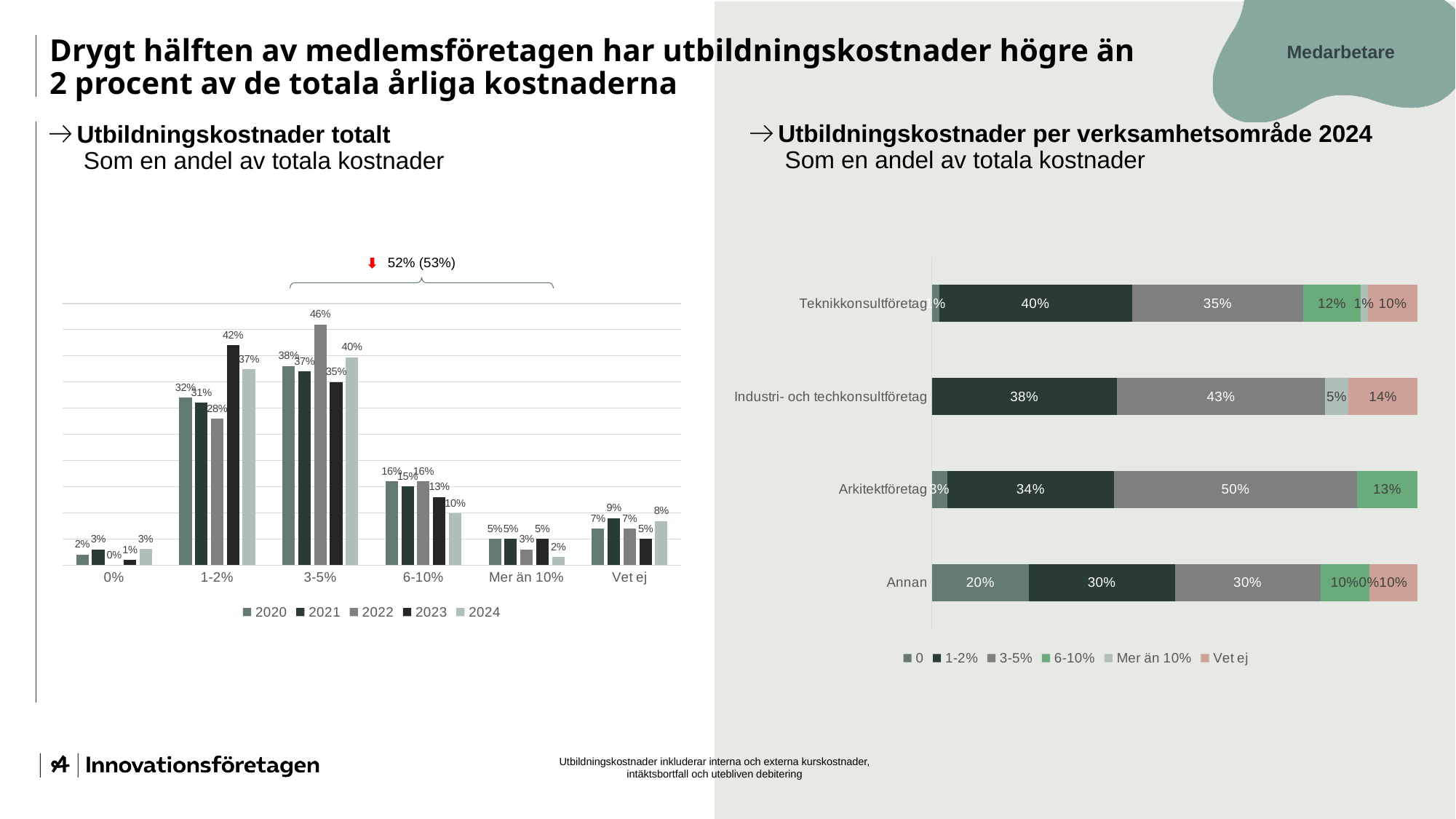
How many categories are shown on the x axis of the left chart 'Utbildningskostnader totalt'? 6 In the left chart 'Utbildningskostnader totalt', what is the value for 2023 in the '1-2%' category? 42% In the right chart 'Utbildningskostnader per verksamhetsområde 2024', what is the 'Vet ej' share for Industri- och techkonsultföretag? 14% In the left chart 'Utbildningskostnader totalt', what is the value for 2022 in the '3-5%' category? 46% In the left chart 'Utbildningskostnader totalt', which year has the highest value in the '6-10%' category? 2020 and 2022 (16%) In the left chart 'Utbildningskostnader totalt', what is the difference between the 2024 value and the 2023 value in the '3-5%' category? 5 percentage points In the right chart 'Utbildningskostnader per verksamhetsområde 2024', which category has the largest '0' share? Annan What kind of chart is the right chart 'Utbildningskostnader per verksamhetsområde 2024'? Stacked horizontal bar chart How many series does the legend of the left chart 'Utbildningskostnader totalt' list? 5 In the left chart 'Utbildningskostnader totalt', is the 2024 value for 'Vet ej' larger or smaller than the 2023 value for 'Vet ej'? larger In the left chart 'Utbildningskostnader totalt', which year has the lowest value in the '0%' category? 2022 In the right chart 'Utbildningskostnader per verksamhetsområde 2024', what is the '3-5%' share for Arkitektföretag? 50%